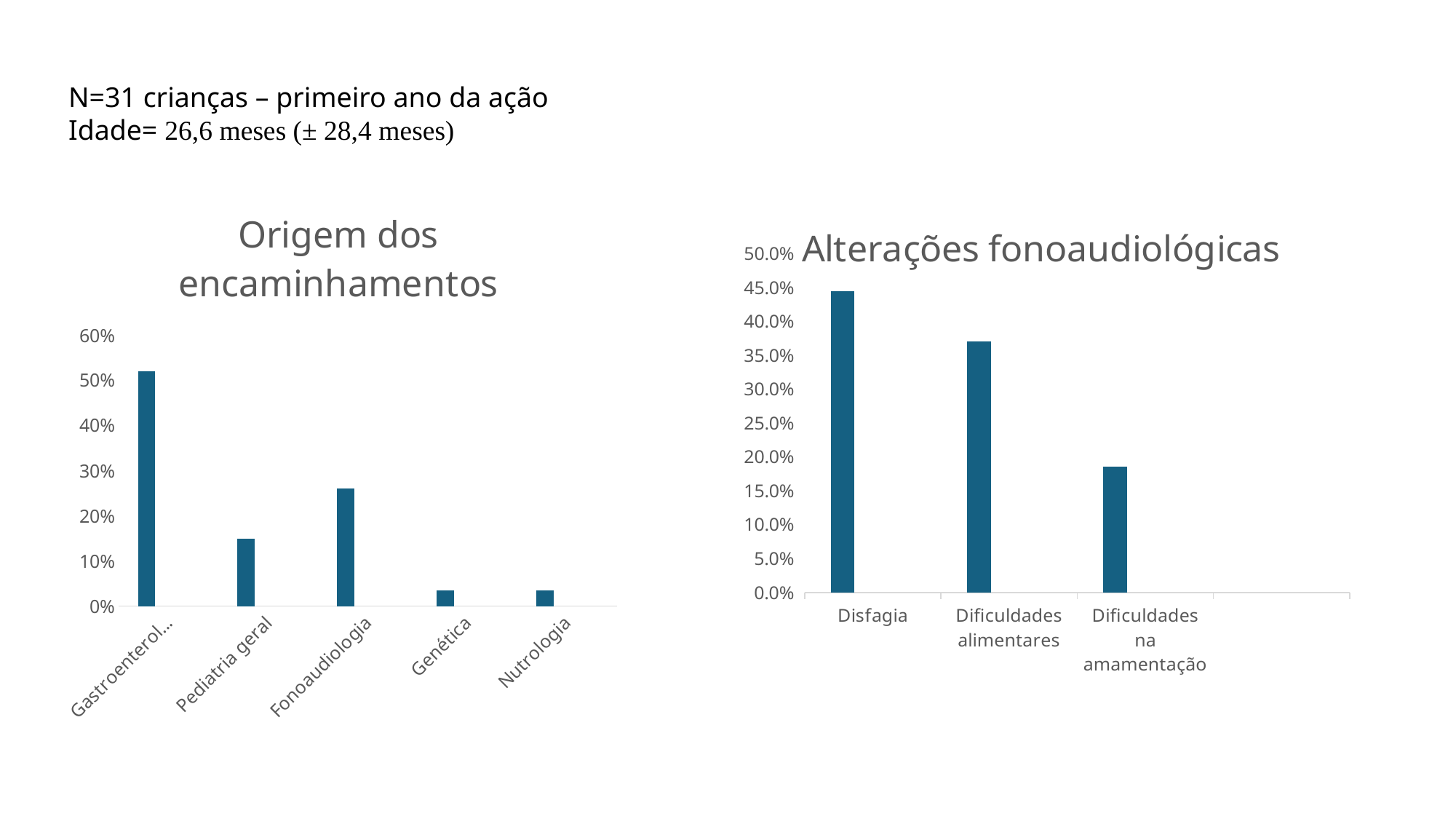
In the 'Origem dos encaminhamentos' chart, is the value for Fonoaudiologia greater or less than 20%? greater How many categories are shown in the 'Origem dos encaminhamentos' chart? 5 How many categories are shown in the 'Alterações fonoaudiológicas' chart? 3 What kind of chart is the 'Alterações fonoaudiológicas' chart on the right? bar chart What is the title of the chart on the left side of the slide? Origem dos encaminhamentos In the 'Alterações fonoaudiológicas' chart, which category has the lowest value? Dificuldades na amamentação In the 'Origem dos encaminhamentos' chart, which is larger: Fonoaudiologia or Pediatria geral? Fonoaudiologia In the 'Alterações fonoaudiológicas' chart, which category has the highest value? Disfagia In the 'Alterações fonoaudiológicas' chart, which is larger: Disfagia or Dificuldades alimentares? Disfagia In the 'Origem dos encaminhamentos' chart, is the value for Pediatria geral greater or less than 20%? less In the 'Alterações fonoaudiológicas' chart, is the value for Disfagia greater or less than 40.0%? greater